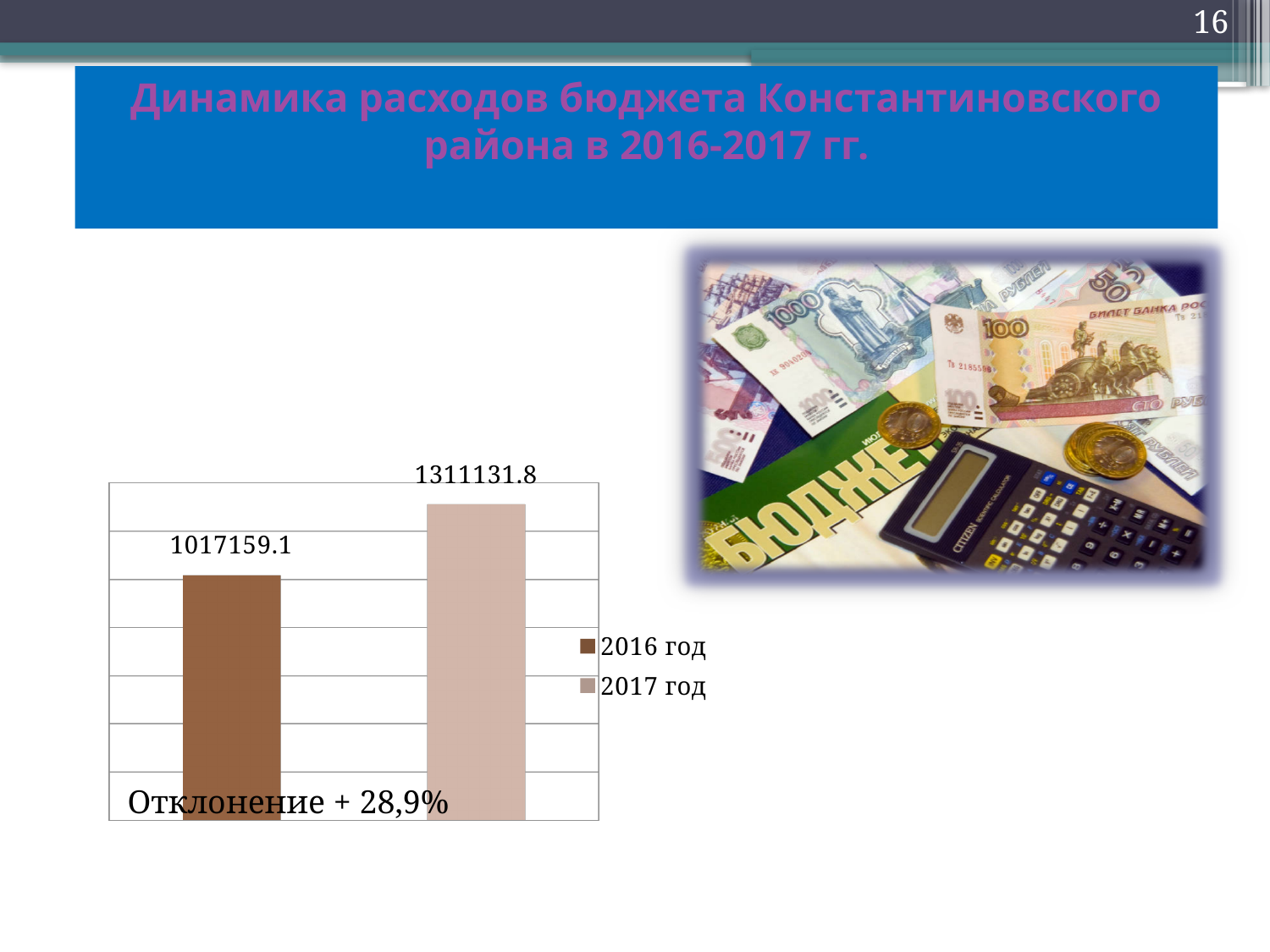
What is the difference between the 2017 год value and the 2016 год value? 293972.7 What is the value shown for 2016 год? 1017159.1 How many bars are plotted on the chart? 2 What is the value shown for 2017 год? 1311131.8 Do the values rise or fall from 2016 год to 2017 год? rise Which year has the higher value, 2016 год or 2017 год? 2017 год What deviation (Отклонение) is printed on the chart? + 28,9% Which series has the highest value on the chart? 2017 год What is the title of the slide containing the chart? Динамика расходов бюджета Константиновского района в 2016-2017 гг. How many series does the legend list? 2 Which series has the lowest value on the chart? 2016 год What kind of chart is shown on the slide? bar chart